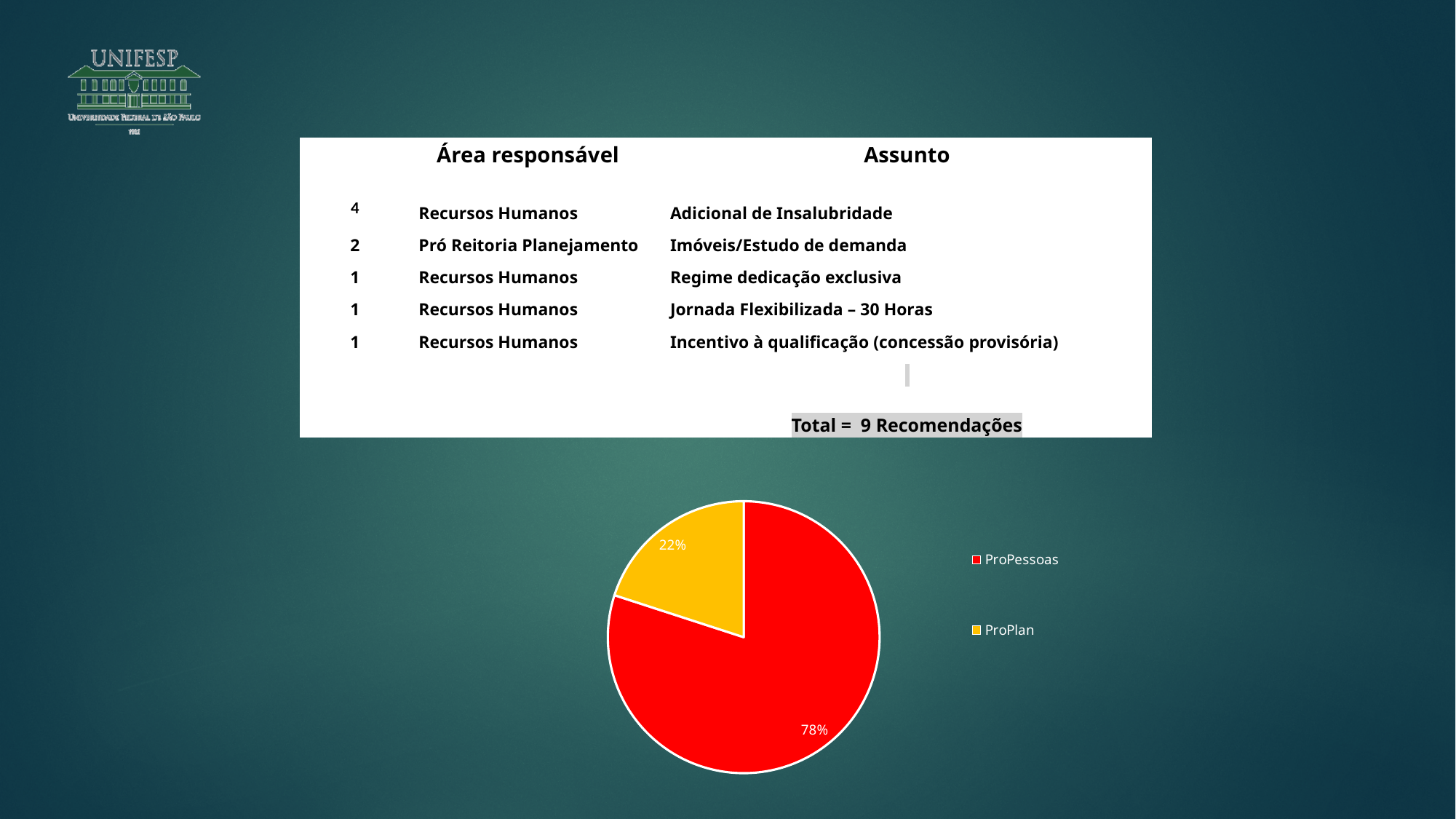
How many slices does the pie chart have? 2 What colour is the ProPessoas slice? red How many entries does the legend list? 2 Which slice of the pie is the largest? ProPessoas What is the difference in percentage points between the ProPessoas and ProPlan slices? 56 What share of the pie does ProPessoas represent? 78% What share of the pie does ProPlan represent? 22% What colour is the ProPlan slice? yellow What kind of chart is shown on the slide? pie chart Which is larger, the ProPessoas slice or the ProPlan slice? ProPessoas Which slice of the pie is the smallest? ProPlan